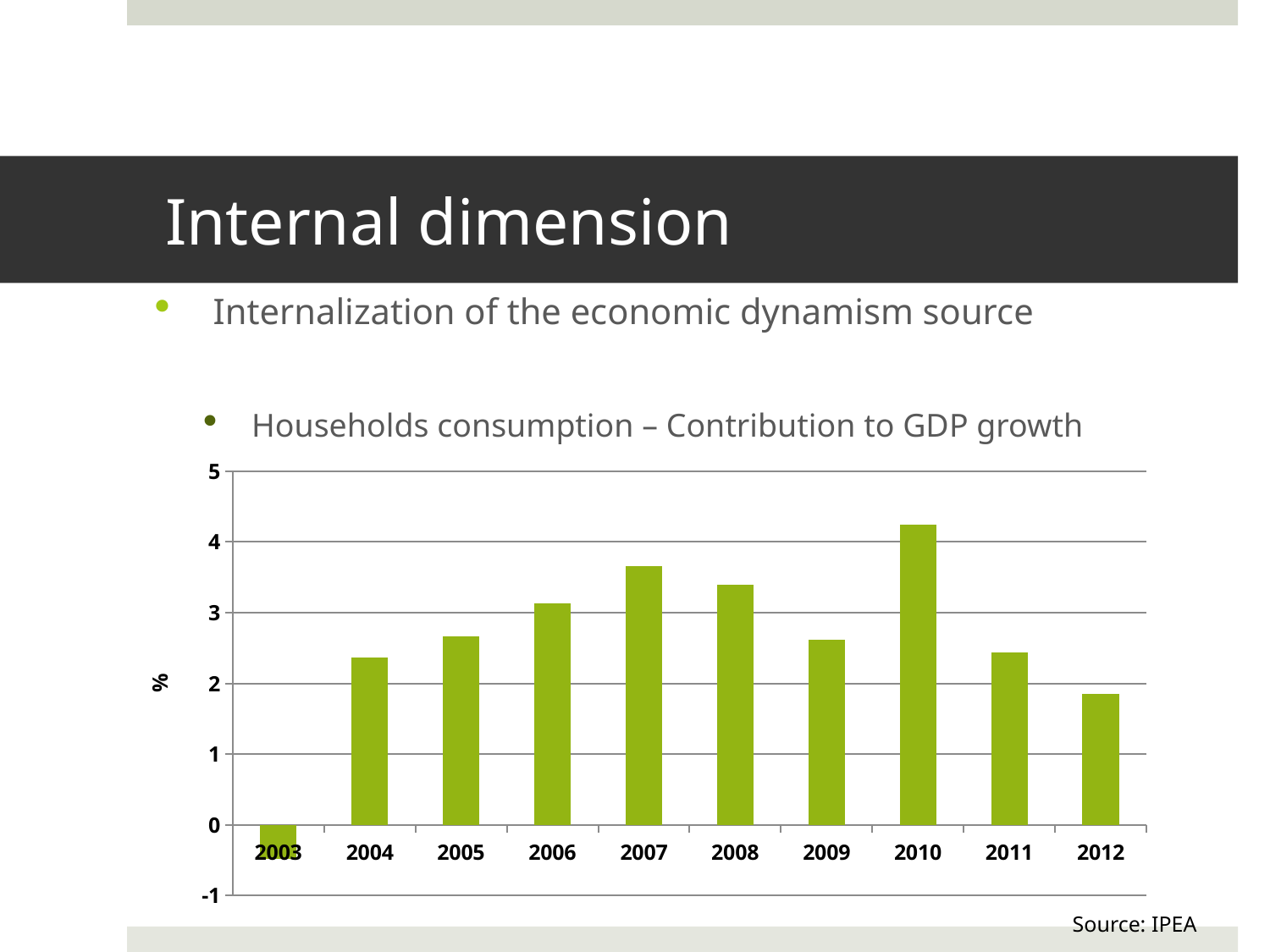
Which year has the lowest households consumption contribution to GDP growth? 2003 Which year has the larger value, 2007 or 2008? 2007 Do the values rise or fall from 2004 to 2007? rise What is the label on the vertical axis of the chart? % Is the value for 2010 greater or less than 4? greater Which year has the highest households consumption contribution to GDP growth? 2010 Is the value for 2009 greater or less than 3? less How many years are shown on the x axis of the chart? 10 Is the value for 2003 greater or less than 0? less What kind of chart is shown on the slide? bar chart